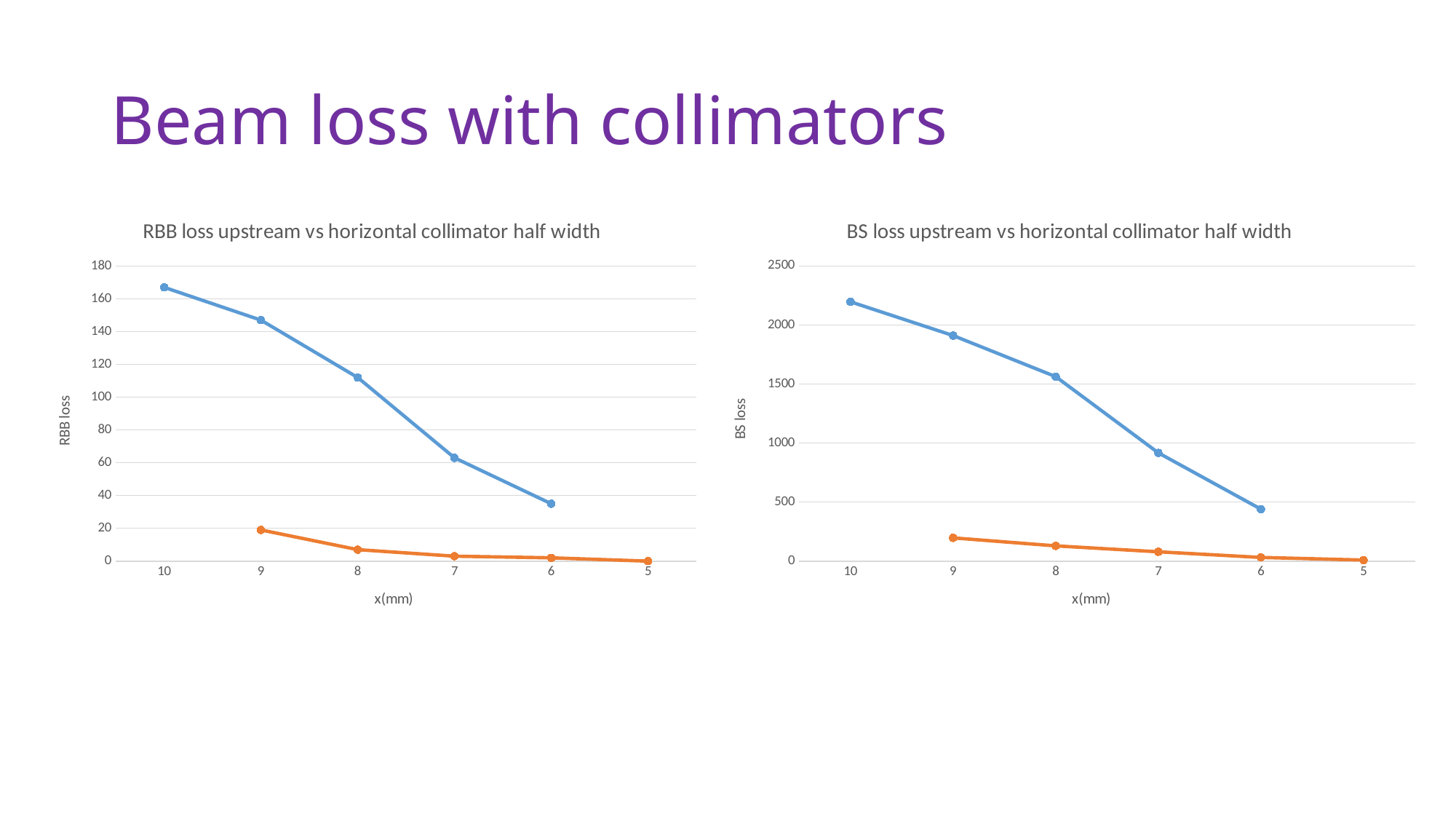
In the right chart (BS loss), is the blue series value at x = 6 mm greater or less than 500? less What is the title of the right chart? BS loss upstream vs horizontal collimator half width In the right chart (BS loss), is the blue series value at x = 7 mm greater or less than 1000? less In the left chart (RBB loss), is the blue series value at x = 7 mm greater or less than 80? less What kind of chart is the left chart titled 'RBB loss upstream vs horizontal collimator half width'? line chart What is the x-axis label on the left chart? x(mm) In the left chart (RBB loss), at x = 9 mm, which series has the larger value, the blue or the orange? blue In the right chart (BS loss), do the blue series values rise or fall moving left to right along the x axis? fall How many x-axis tick values are shown on the right chart (BS loss)? 6